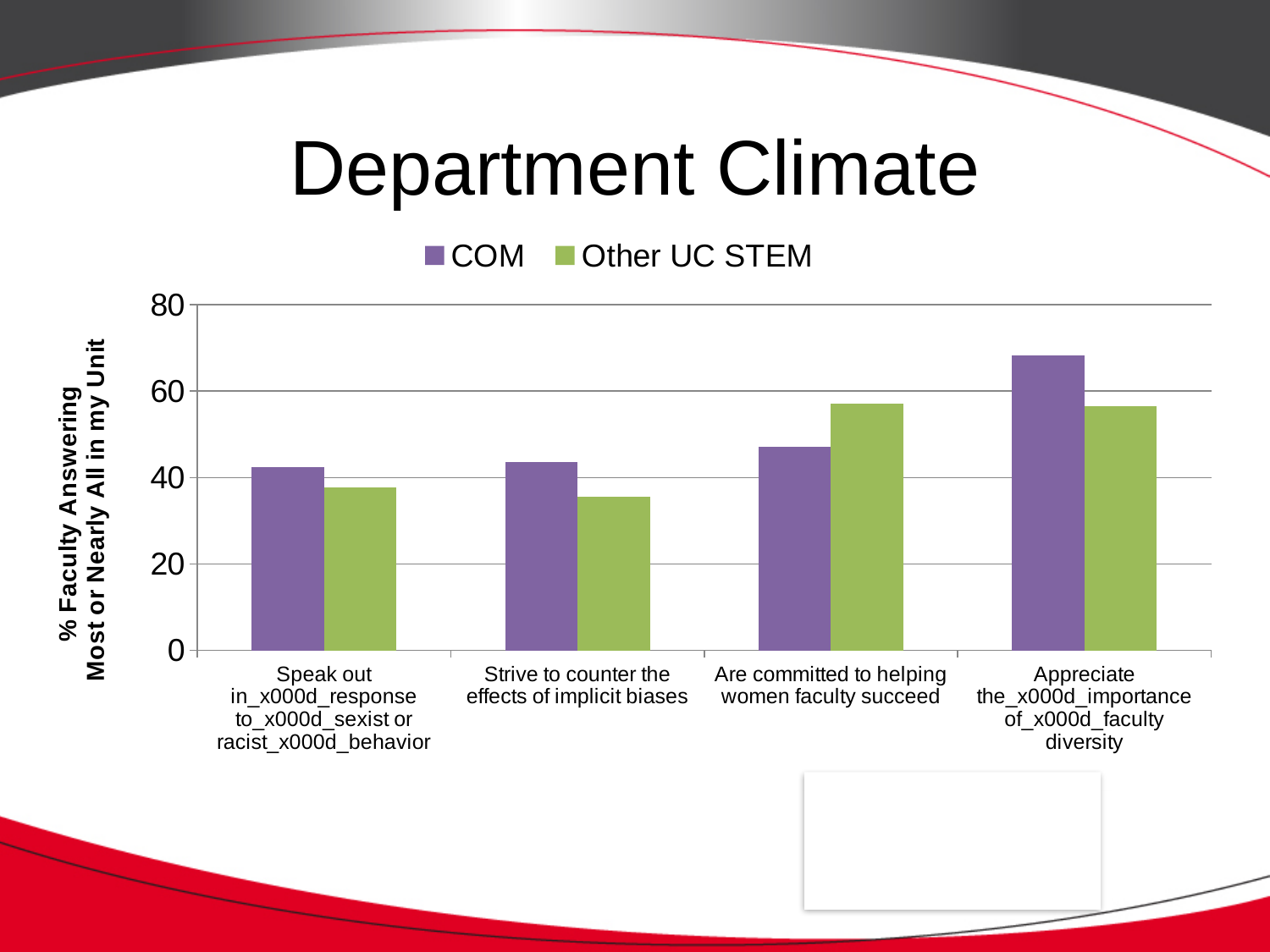
What is the title of the chart? Department Climate What kind of chart is shown on the slide? bar chart Is the COM value for 'Appreciate the importance of faculty diversity' greater or less than 60? greater For which category is the COM value highest? Appreciate the importance of faculty diversity How many series does the legend list? 2 Which series are listed in the legend? COM and Other UC STEM Is the Other UC STEM value for 'Strive to counter the effects of implicit biases' greater or less than 40? less How many categories are shown along the x axis? 4 For 'Are committed to helping women faculty succeed', which series has the larger value, COM or Other UC STEM? Other UC STEM Is the COM value for 'Are committed to helping women faculty succeed' greater or less than 60? less For which category is the Other UC STEM value highest? Are committed to helping women faculty succeed For 'Appreciate the importance of faculty diversity', which series has the larger value, COM or Other UC STEM? COM